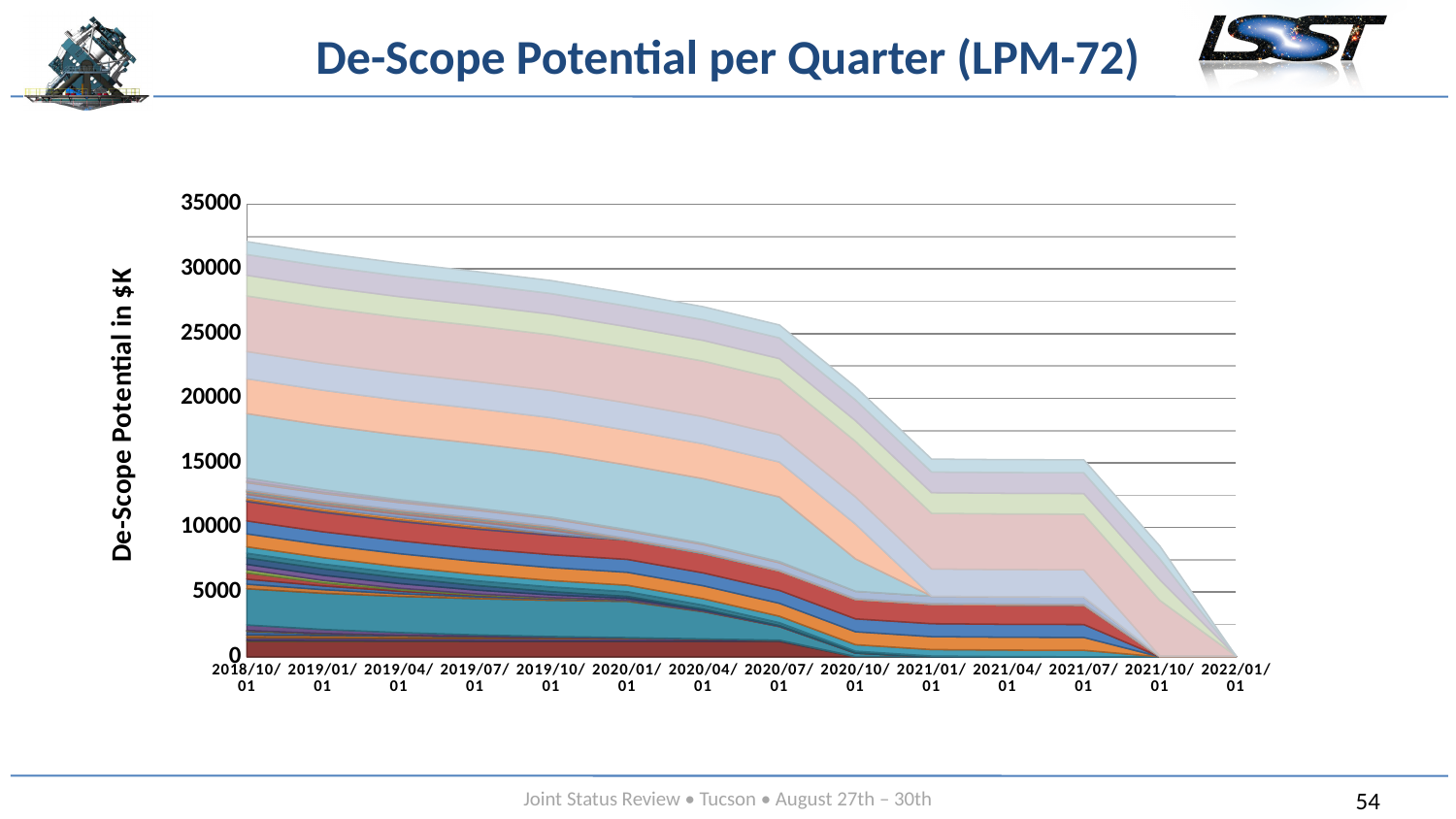
Is the total de-scope potential at 2020/07/01 greater or less than 25000? greater What is the title of the vertical axis of the chart? De-Scope Potential in $K Is the total de-scope potential at 2018/10/01 greater or less than 30000? greater At which date is the total de-scope potential highest? 2018/10/01 Is the total de-scope potential at 2021/10/01 greater or less than 10000? less How many dates are labelled along the x axis of the chart? 14 What kind of chart is shown on the slide? Stacked area chart At which date is the total de-scope potential lowest? 2022/01/01 Does the total de-scope potential rise or fall from 2018/10/01 to 2022/01/01? Fall What is the highest value shown on the vertical axis of the chart? 35000 Which date has the larger total de-scope potential, 2019/01/01 or 2021/04/01? 2019/01/01